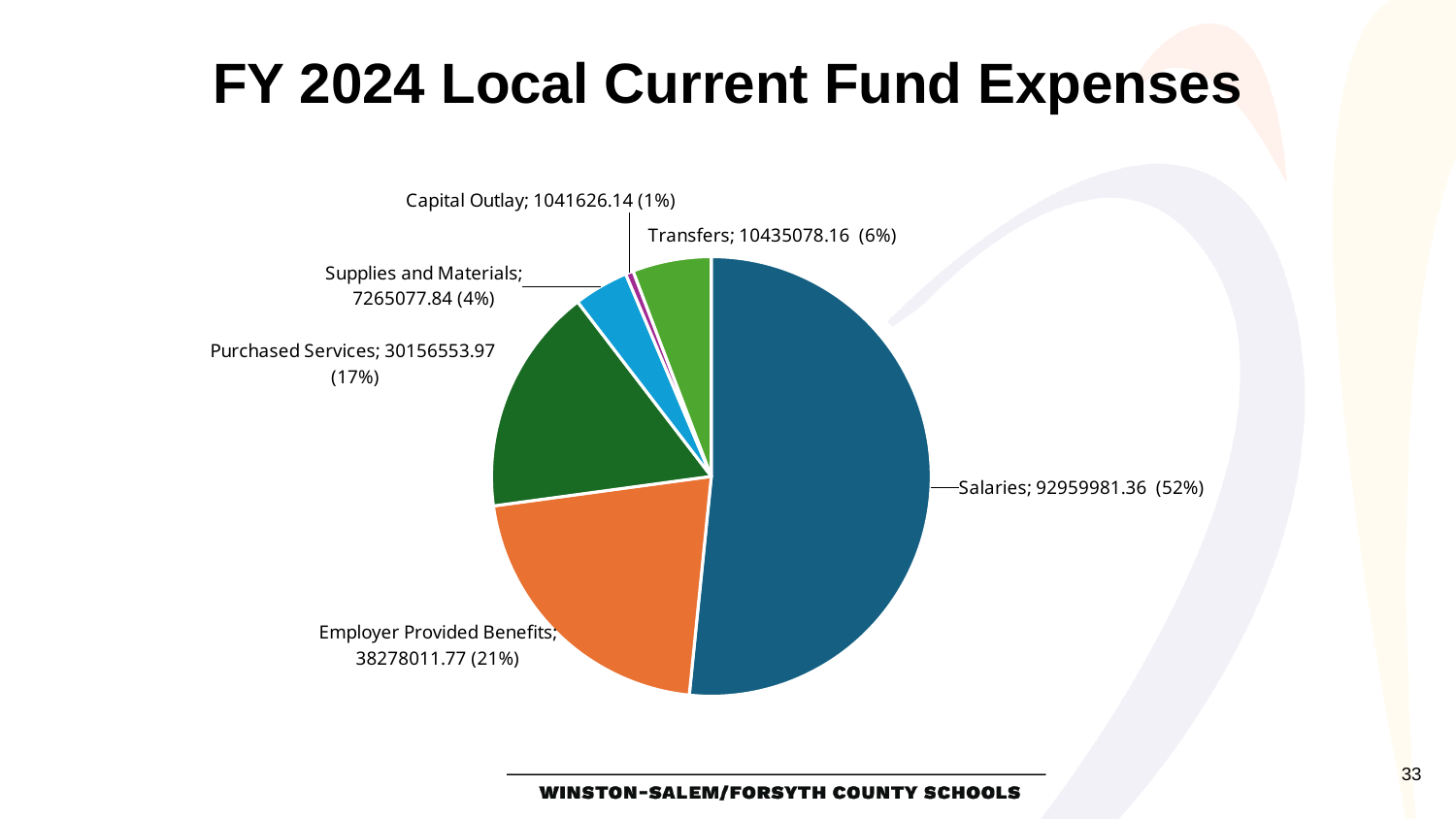
Which category has the largest slice of the pie? Salaries What is the value for Salaries? 92959981.36 What type of chart is shown on the slide? Pie chart What share of the pie does Employer Provided Benefits represent? 21% How many categories are shown in the pie chart? 6 What share of the pie does Transfers represent? 6% What is the difference between the values for Salaries and Employer Provided Benefits? 54681969.59 Which category has the smallest slice of the pie? Capital Outlay Which is larger, Transfers or Supplies and Materials? Transfers What is the value for Capital Outlay? 1041626.14 What is the value for Purchased Services? 30156553.97 What is the value for Employer Provided Benefits? 38278011.77